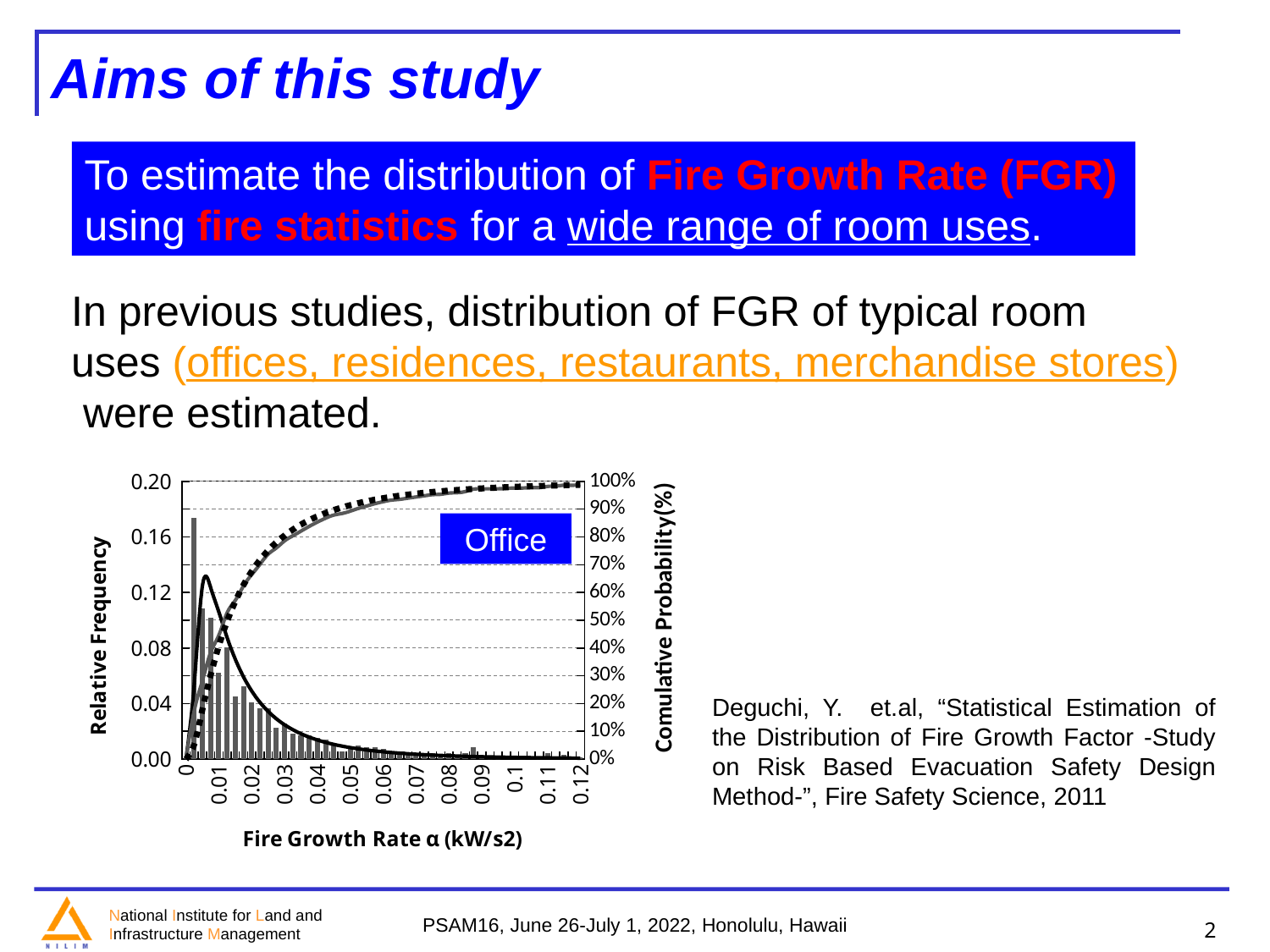
What is the title of the x axis of the chart? Fire Growth Rate α (kW/s2) Is the cumulative probability at a fire growth rate of 0.01 greater or less than 60%? less Does the cumulative probability curve rise or fall as the fire growth rate increases? rise What kind of chart is shown on the slide? Bar chart (histogram) with overlaid line curves Is the relative frequency of the bar at a fire growth rate of 0.08 greater or less than 0.04? less Is the relative frequency of the tallest bar greater or less than 0.12? greater Which is larger, the relative frequency of the bars near a fire growth rate of 0.005 or near 0.05? near 0.005 Which room use is labelled in the box inside the chart? Office Do the relative frequency bars rise or fall as the fire growth rate increases from 0.02 to 0.12? fall